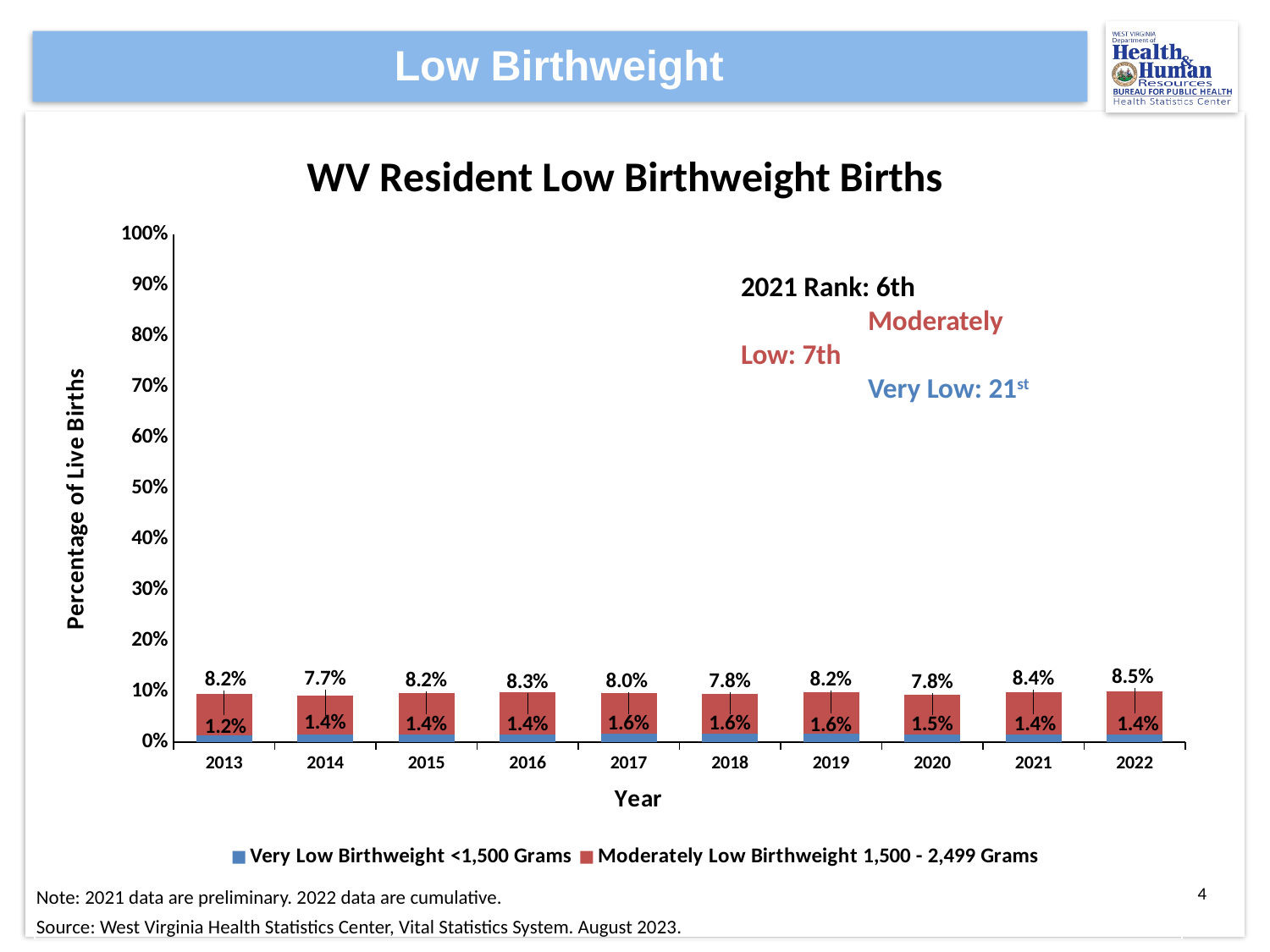
What is the difference between the upper data labels for 2022 and 2014? 0.8 percentage points What type of chart is shown on the slide? Stacked bar chart What is the Very Low Birthweight value for 2013? 1.2% Which year has the lowest Very Low Birthweight value? 2013 Which year has the lowest upper data label on its bar? 2014 What is the title of the y axis? Percentage of Live Births What is the upper data label shown on the 2021 bar? 8.4% How many series does the chart legend list? 2 What is the Very Low Birthweight value for 2020? 1.5% How many years are shown on the x axis of the chart? 10 Is the total height of the 2022 bar greater or less than 20%? less Which year has the highest upper data label on its bar? 2022